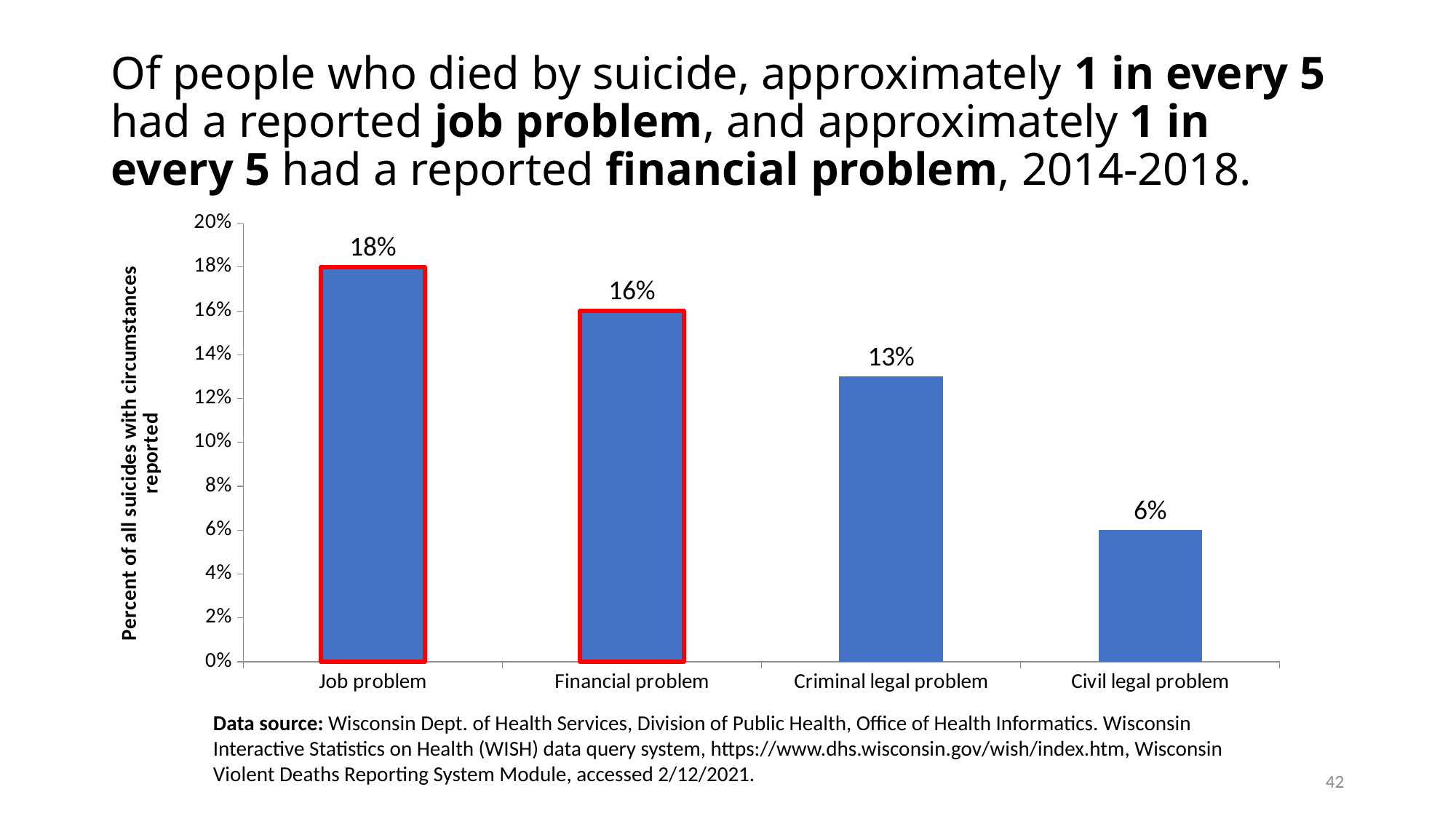
What is the value for Criminal legal problem? 13% How many categories are shown on the x axis? 4 Which category has the highest percentage? Job problem What percent of suicides had a reported job problem? 18% Which two bars are outlined in red? Job problem and Financial problem Which category has the lowest percentage? Civil legal problem Which is larger, the value for Financial problem or Criminal legal problem? Financial problem What kind of chart is shown on the slide? Bar chart What is the difference between the Job problem and Financial problem percentages? 2% What is the value for Civil legal problem? 6% What is the difference between the Criminal legal problem and Civil legal problem percentages? 7% What percent of suicides had a reported financial problem? 16%